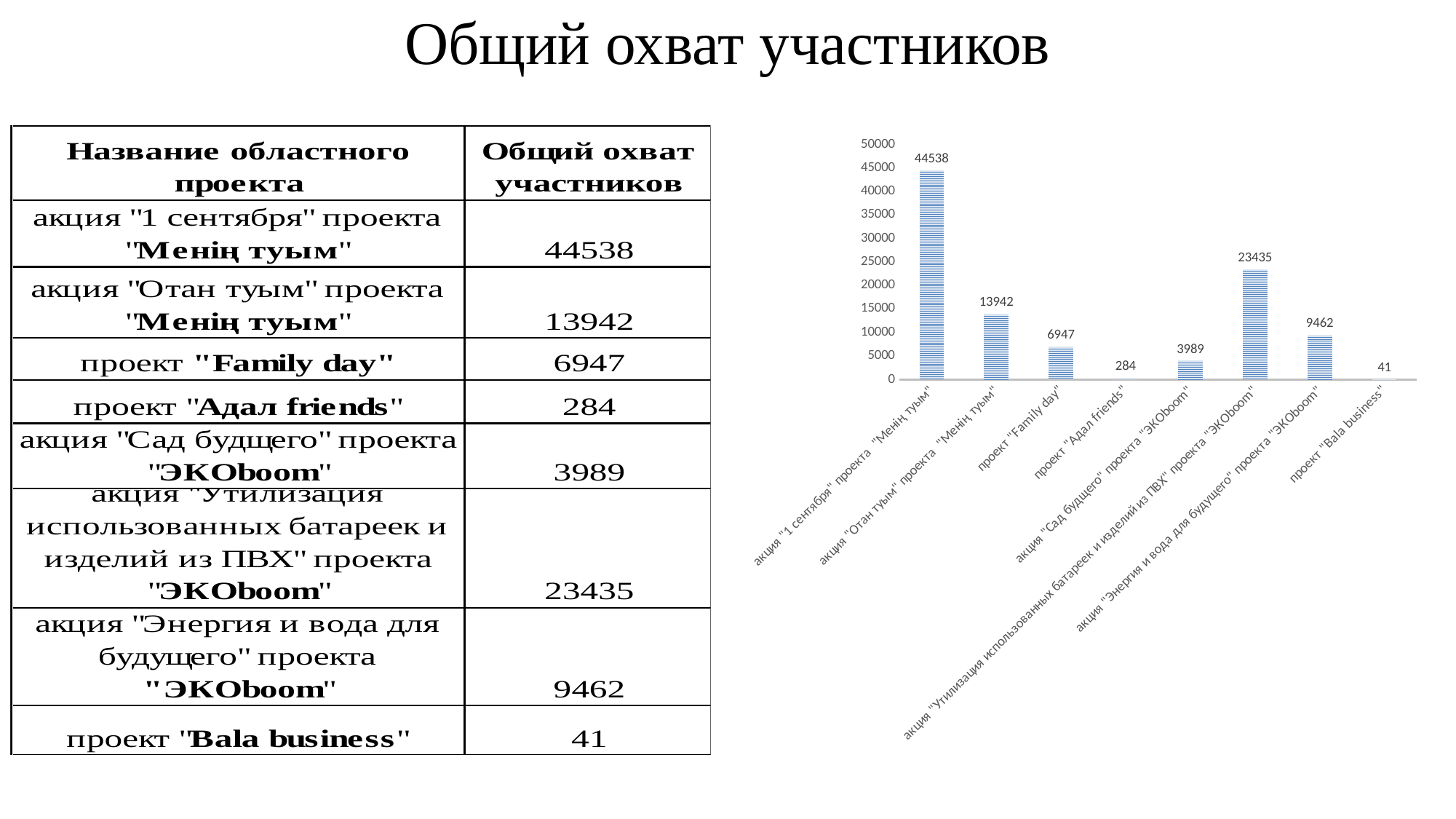
Is the value for акция "Утилизация использованных батареек и изделий из ПВХ" проекта "ЭКОboom" greater or less than 20000? greater What is the difference between the values for проект "Family day" and проект "Адал friends"? 6663 Which category has the lowest value in the chart? проект "Bala business" Which is larger: the value for акция "Утилизация использованных батареек и изделий из ПВХ" проекта "ЭКОboom" or the value for акция "Отан туым" проекта "Менің туым"? акция "Утилизация использованных батареек и изделий из ПВХ" проекта "ЭКОboom" What is the value for проект "Bala business" in the chart? 41 How many categories are shown in the chart? 8 What kind of chart is shown on the slide? bar chart What is the difference between the values for акция "1 сентября" проекта "Менің туым" and акция "Отан туым" проекта "Менің туым"? 30596 Which category has the highest value in the chart? акция "1 сентября" проекта "Менің туым" What is the value for проект "Family day" in the chart? 6947 What is the value for акция "Сад будущего" проекта "ЭКОboom" in the chart? 3989 What is the value for акция "Энергия и вода для будущего" проекта "ЭКОboom" in the chart? 9462